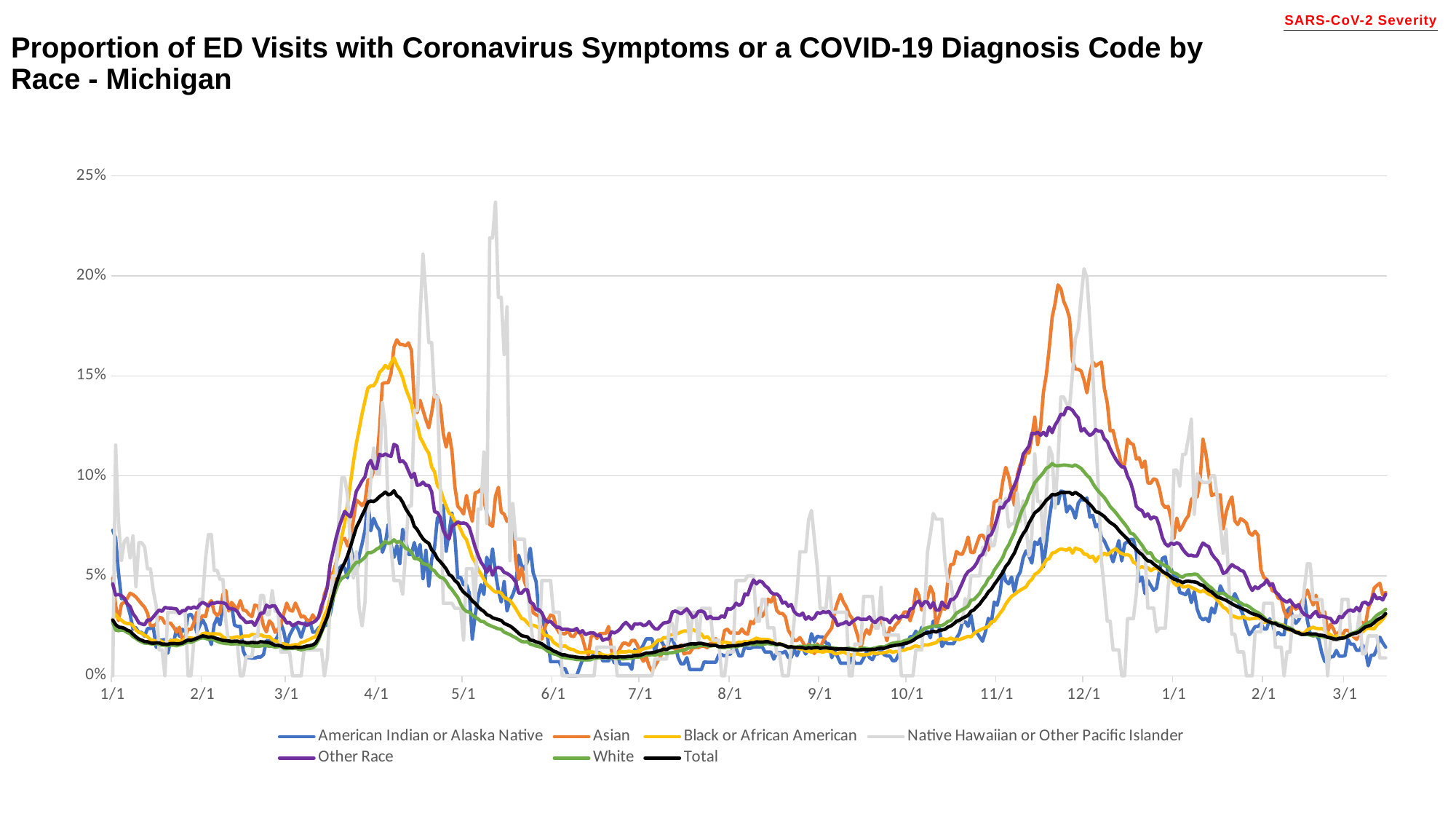
Is the peak value for Other Race around 12/1 greater or less than 10%? greater Is the peak value for Asian around 12/1 greater or less than 15%? greater Is the peak value for Native Hawaiian or Other Pacific Islander around 5/1 greater or less than 20%? greater Does the Total series rise or fall between 4/1 and 6/1? Fall Around 12/1, which series is higher: Asian or Black or African American? Asian What kind of chart is shown on the slide? Line chart Which series reaches the highest value anywhere on the chart? Native Hawaiian or Other Pacific Islander How many series does the legend list? 7 Which series is drawn in black? Total What is the title of the chart? Proportion of ED Visits with Coronavirus Symptoms or a COVID-19 Diagnosis Code by Race - Michigan